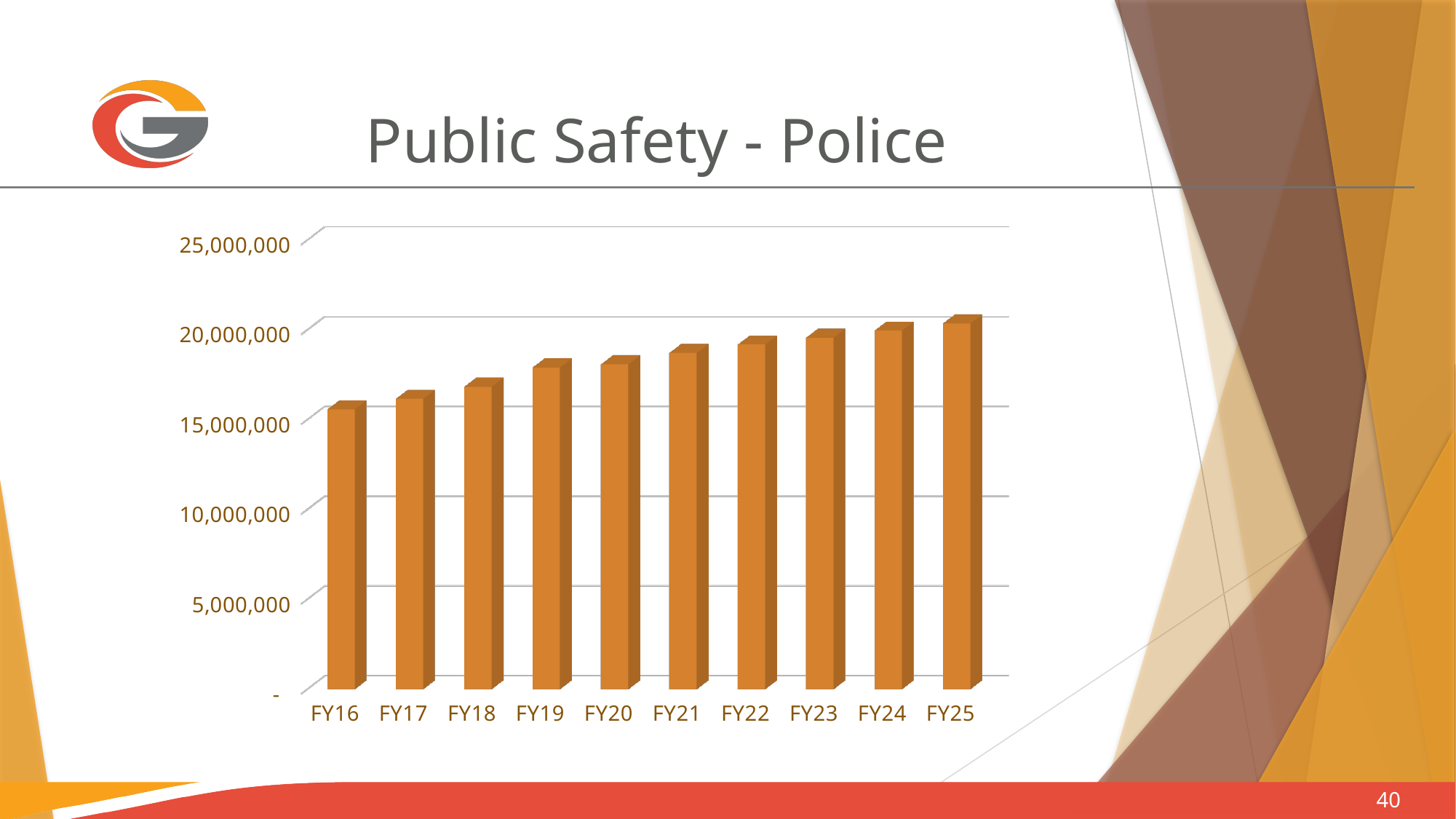
Is the value for FY22 greater or less than 20,000,000? less What is the title of the slide containing the chart? Public Safety - Police Is the value for FY25 greater or less than 25,000,000? less Which fiscal year has the lowest value on the chart? FY16 Do the values rise or fall from FY16 to FY25? rise What kind of chart is shown on the slide? bar chart Which is larger, the value for FY16 or the value for FY20? FY20 Which is larger, the value for FY18 or the value for FY23? FY23 Is the value for FY19 greater or less than 15,000,000? greater Which fiscal year has the highest value on the chart? FY25 How many fiscal years are plotted on the chart? 10